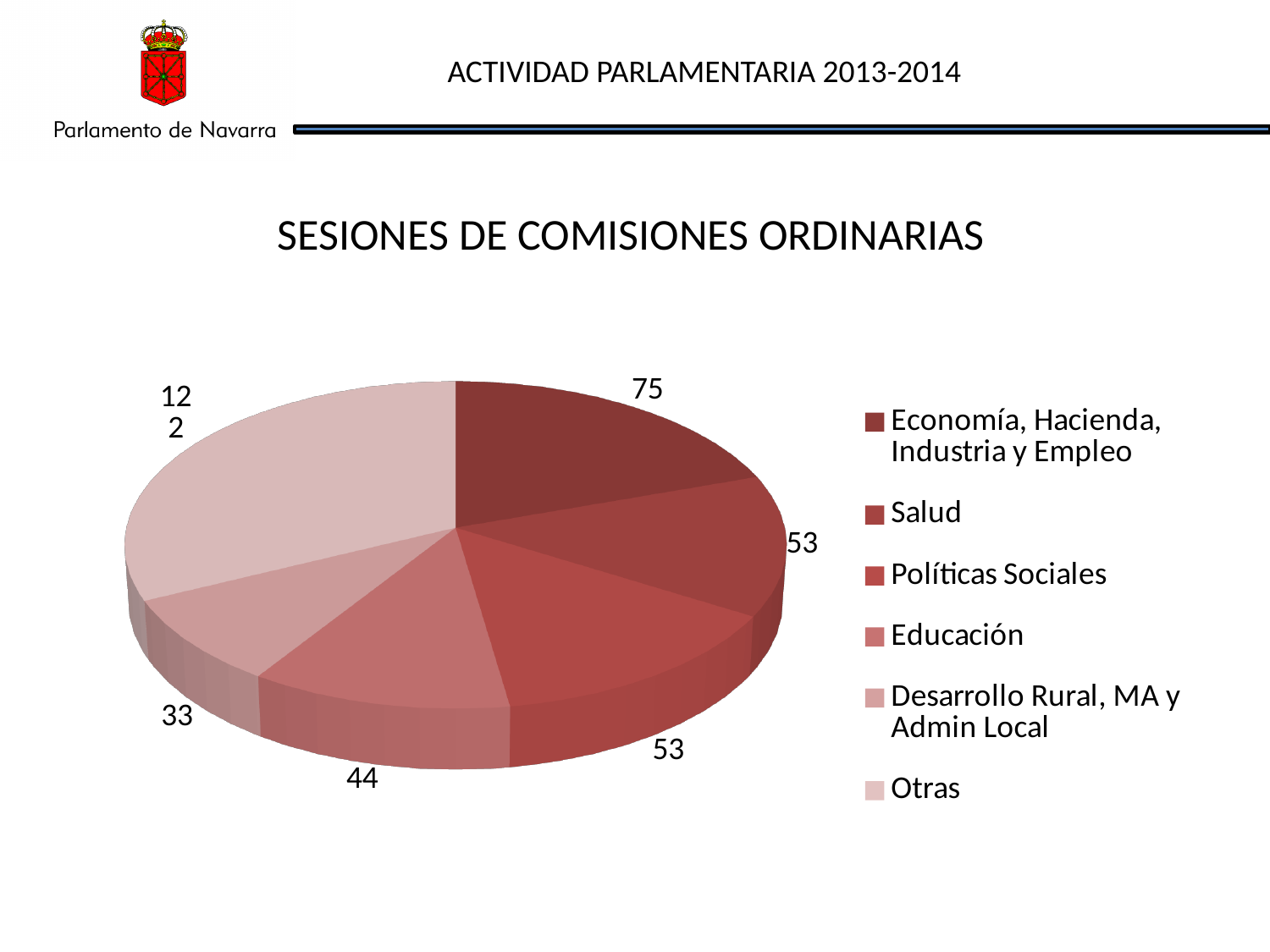
What is the value for Educación? 44 How many sessions are shown for Economía, Hacienda, Industria y Empleo? 75 What is the difference between the values for Economía, Hacienda, Industria y Empleo and Educación? 31 Which is larger, the value for Economía, Hacienda, Industria y Empleo or the value for Salud? Economía, Hacienda, Industria y Empleo What is the value for Salud? 53 How many categories does the pie chart show? 6 What is the title of the chart? SESIONES DE COMISIONES ORDINARIAS Which category has the smallest slice of the pie? Desarrollo Rural, MA y Admin Local What is the value for Políticas Sociales? 53 What is the value for Desarrollo Rural, MA y Admin Local? 33 Which category has the largest slice of the pie? Otras What kind of chart is shown on the slide? Pie chart